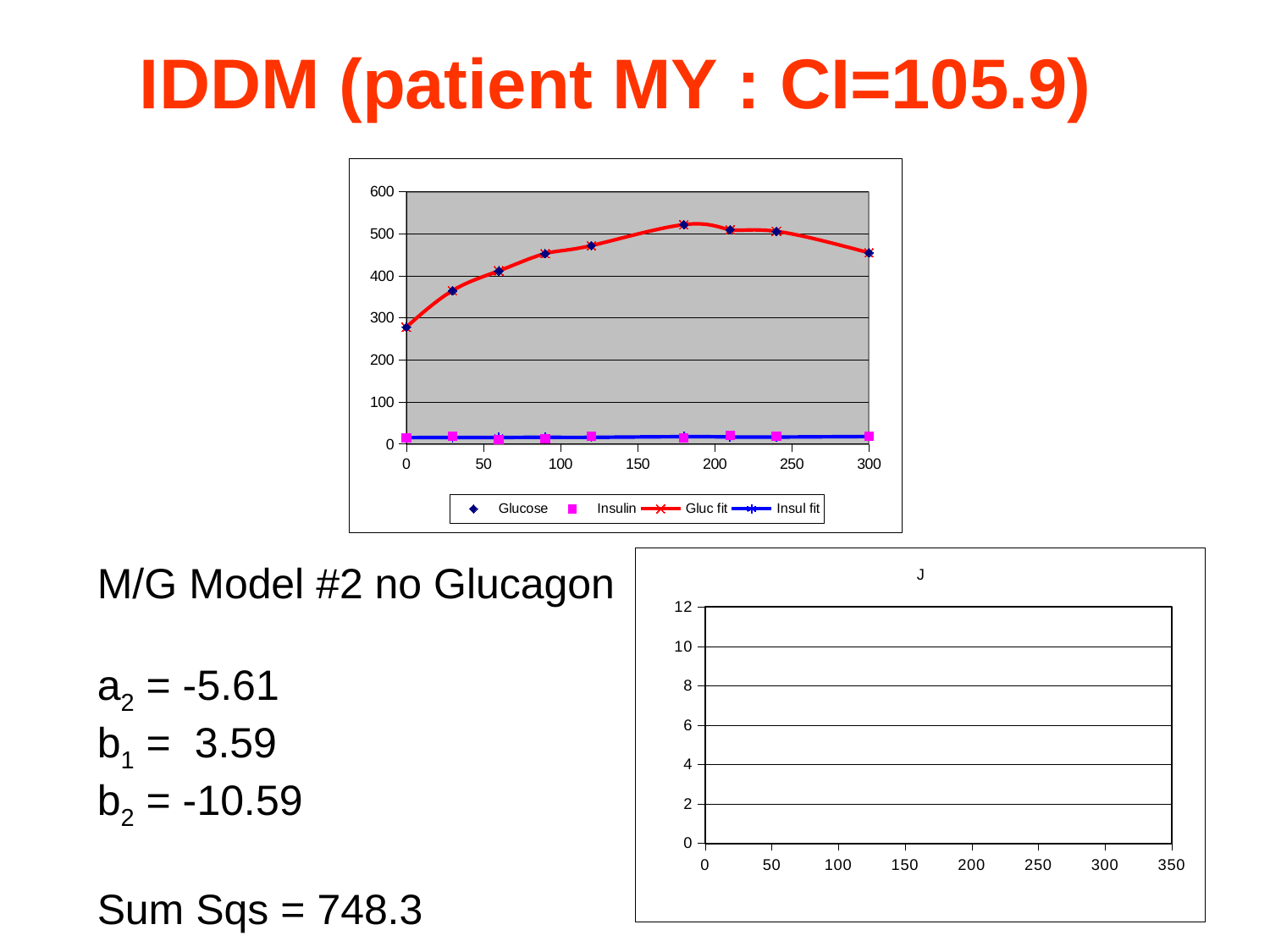
In the top chart, at which x value is the Glucose value lowest? 0 In the top chart, is the Glucose value at x = 180 greater or less than 500? greater In the top chart, is the Glucose value at x = 300 greater or less than 500? less In the top chart, is the Glucose value at x = 0 greater or less than 300? less In the top chart, do the Glucose values rise or fall between x = 0 and x = 120? rise What kind of chart is the top chart on the slide? line chart In the top chart, what are the names of the series in the legend? Glucose, Insulin, Gluc fit, Insul fit In the top chart, which is larger: the Glucose value at x = 300 or the Glucose value at x = 0? Glucose at x = 300 In the top chart, do the Glucose values rise or fall between x = 180 and x = 300? fall In the top chart, how many series does the legend list? 4 What is the title of the bottom chart on the slide? J